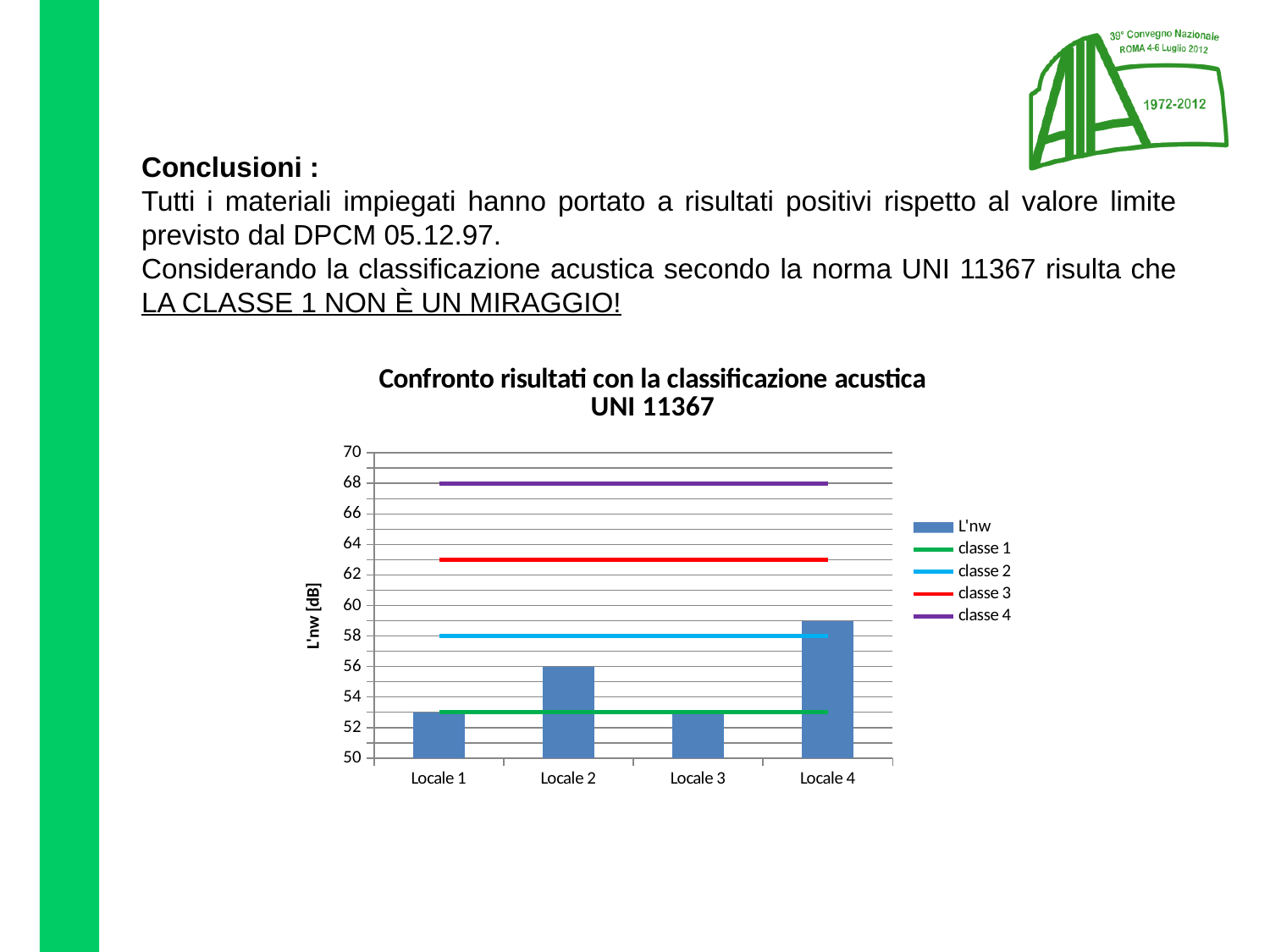
How many locali (categories) are shown on the x axis? 4 What kind of chart is shown on the slide? combination bar and line chart Is the L'nw value for Locale 2 greater or less than 58? less Which has the larger L'nw value, Locale 4 or Locale 1? Locale 4 Which has the larger L'nw value, Locale 2 or Locale 3? Locale 2 At what L'nw value does the classe 4 line sit? 68 What is the label of the y axis? L'nw [dB] How many series does the legend list? 5 Which locale has the highest L'nw value? Locale 4 At what L'nw value does the classe 2 line sit? 58 Is the L'nw value for Locale 1 greater or less than 54? less Is the L'nw value for Locale 4 greater or less than 58? greater